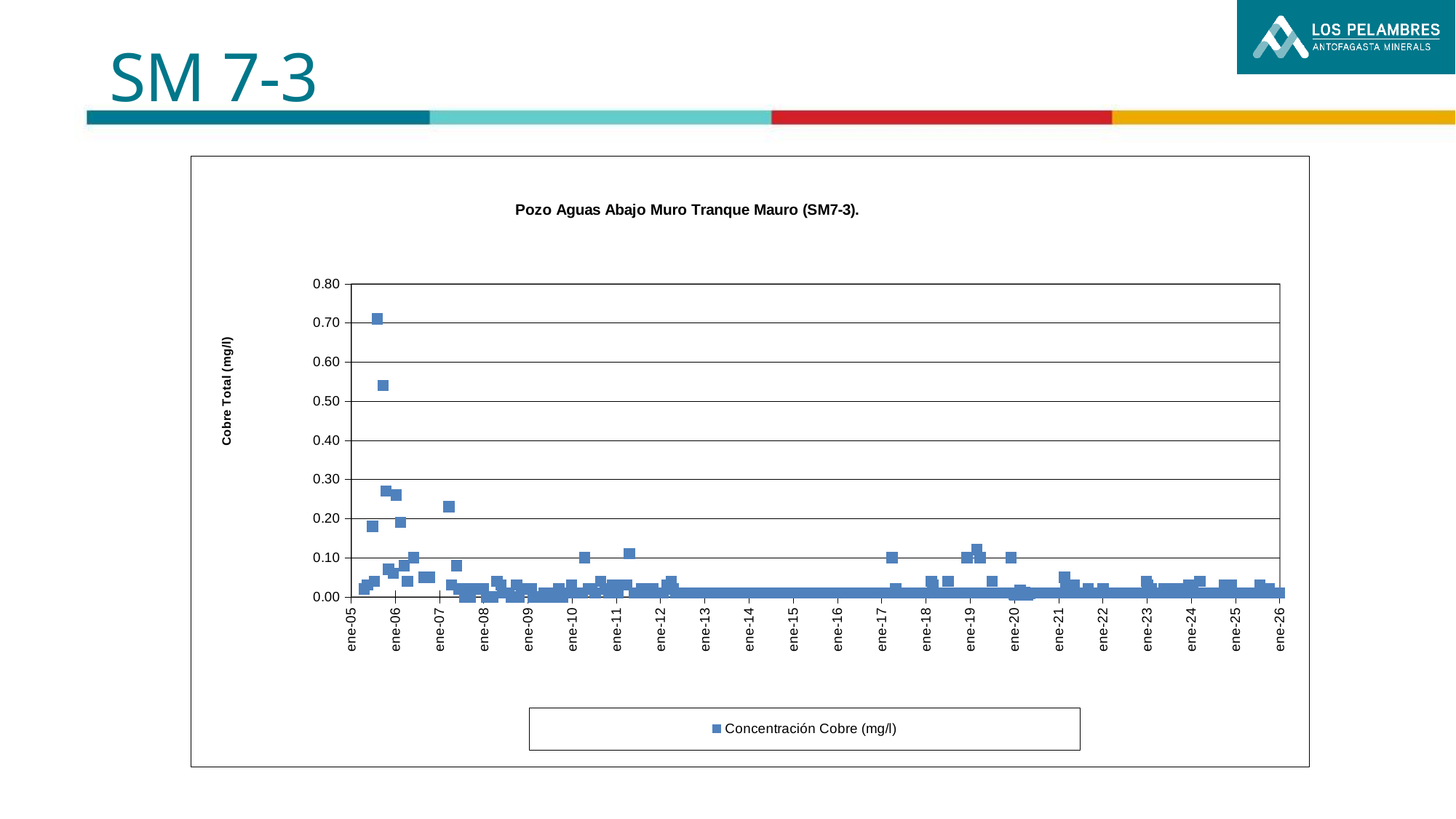
Overall, do the copper concentration values rise or fall from ene-05 to ene-26? fall What is the label of the vertical axis? Cobre Total (mg/l) What is the highest value shown on the vertical axis? 0.80 How many tick labels are shown on the horizontal axis? 22 What is the last label on the horizontal axis? ene-26 How many series does the legend list? 1 Are the plotted values between ene-13 and ene-16 greater or less than 0.10? less What is the name of the series shown in the legend? Concentración Cobre (mg/l) Is the highest plotted value on the chart greater or less than 0.60? greater What is the title of the chart? Pozo Aguas Abajo Muro Tranque Mauro (SM7-3). What kind of chart is shown on the slide? scatter chart What is the first label on the horizontal axis? ene-05